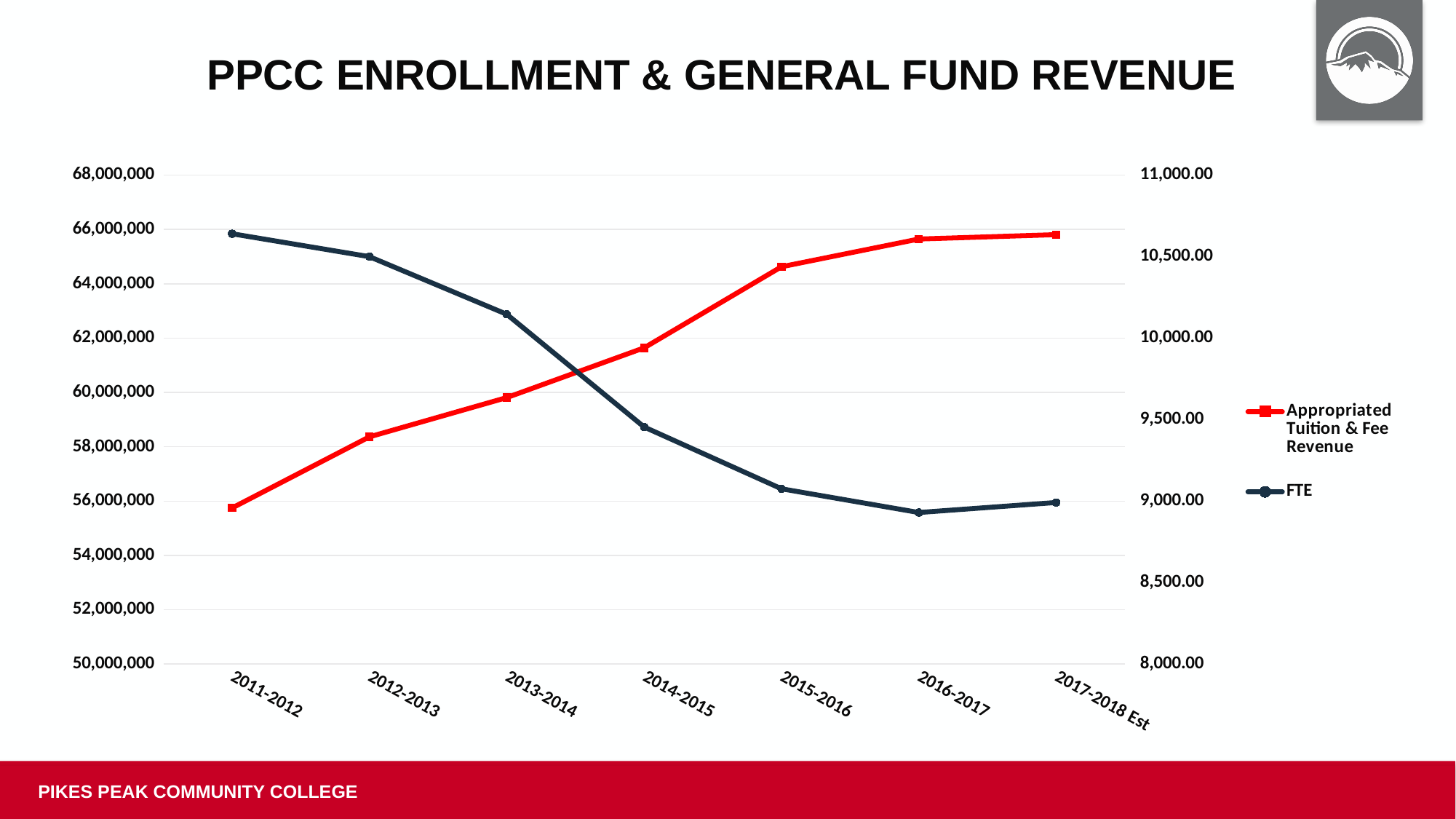
Is the Appropriated Tuition & Fee Revenue for 2015-2016 greater or less than 64,000,000? greater How many series does the legend list? 2 Does the FTE line rise or fall from 2011-2012 to 2016-2017? fall Which is larger, the FTE for 2012-2013 or the FTE for 2015-2016? 2012-2013 Is the FTE for 2016-2017 greater or less than 9,000.00? less Which year has the lowest Appropriated Tuition & Fee Revenue? 2011-2012 Which year has the highest FTE? 2011-2012 What kind of chart is shown on the slide? line chart Is the FTE for 2013-2014 greater or less than 10,000.00? greater Does the Appropriated Tuition & Fee Revenue line rise or fall from 2011-2012 to 2017-2018 Est? rise How many academic years are plotted along the x axis? 7